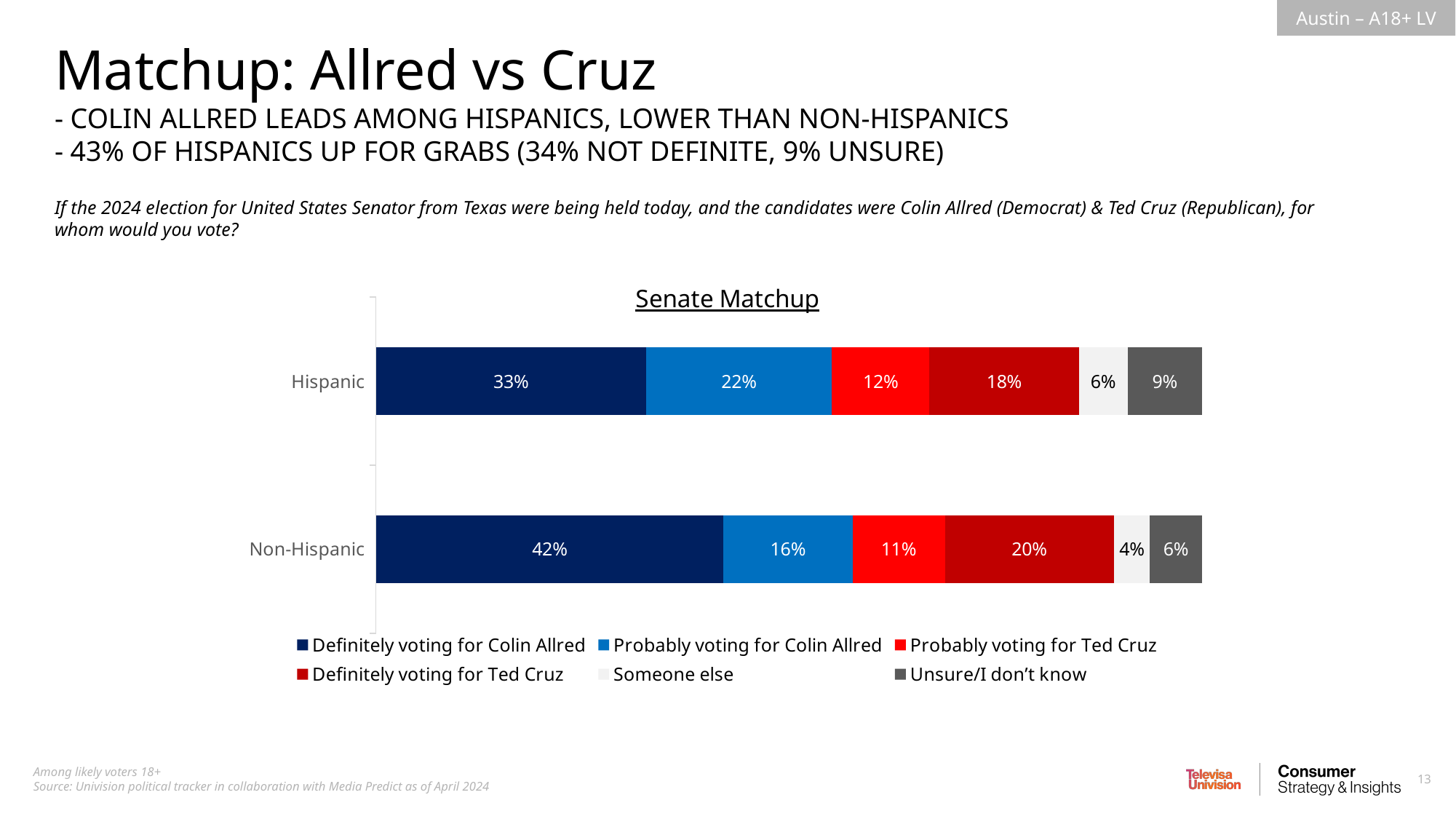
What is the value for 'Someone else' among Non-Hispanic voters? 4% What is the difference between the Hispanic and Non-Hispanic shares who are unsure? 3 percentage points Which response category is the largest segment in the Hispanic bar? Definitely voting for Colin Allred Which response category is the smallest segment in the Non-Hispanic bar? Someone else What type of chart is shown on the slide? Stacked bar chart What percentage of Non-Hispanic likely voters are definitely voting for Ted Cruz? 20% What percentage of Hispanic likely voters are definitely voting for Colin Allred? 33% What is the value for 'Unsure/I don't know' among Hispanic voters? 9% Which group has the higher share probably voting for Colin Allred, Hispanic or Non-Hispanic? Hispanic How many series does the legend list? 6 What is the difference between the Non-Hispanic and Hispanic shares definitely voting for Colin Allred? 9 percentage points Which group has the higher share definitely voting for Colin Allred, Hispanic or Non-Hispanic? Non-Hispanic